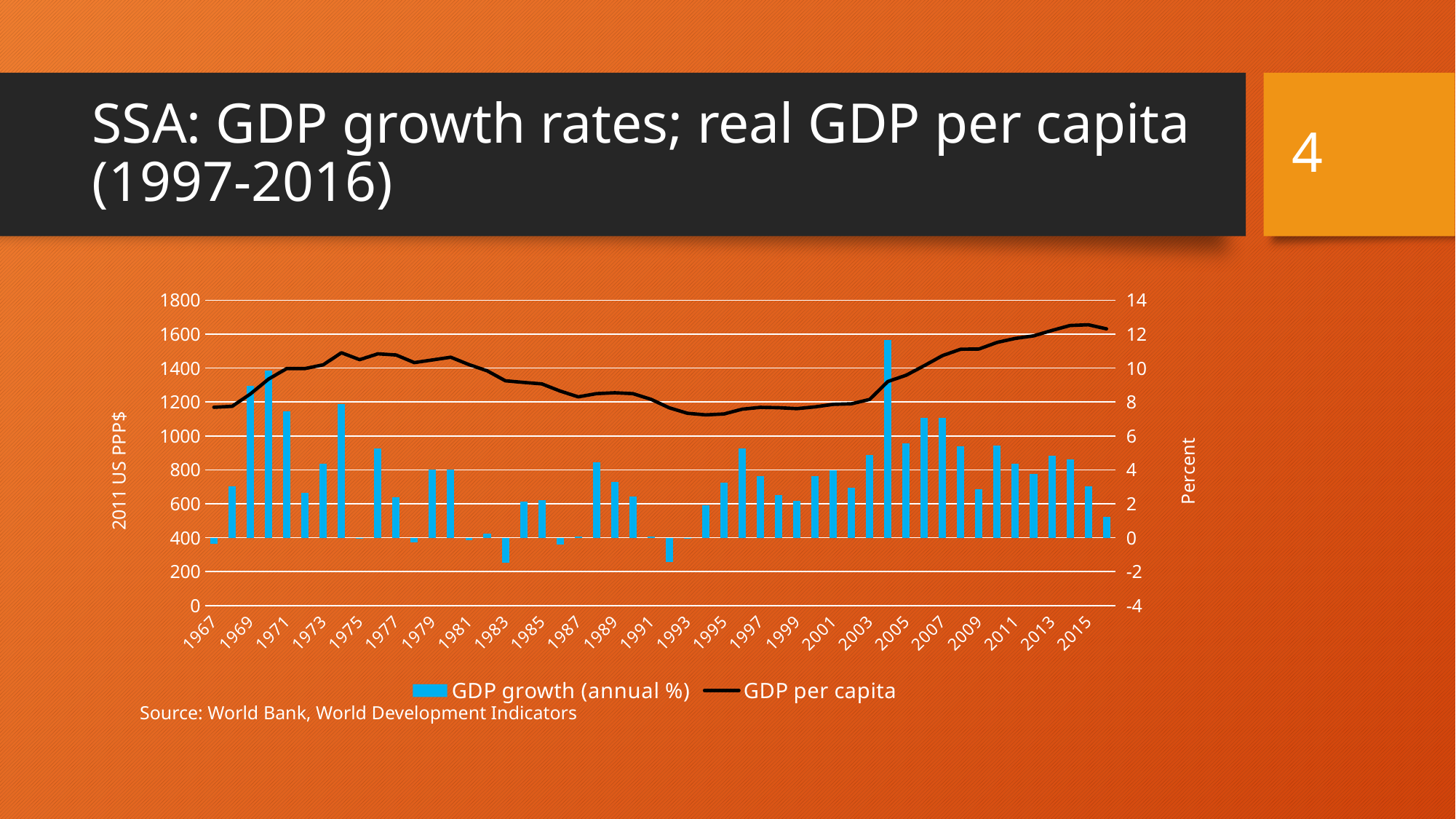
What kind of chart is shown on the slide? A combined bar and line chart Is the GDP growth (annual %) value for 2004 greater or less than 10? greater Is the GDP growth (annual %) value for 1983 greater or less than 0? less How many series does the legend list? 2 What is the title of the left vertical axis? 2011 US PPP$ Is the GDP per capita value for 2015 greater or less than 1600? greater Which year has the larger GDP per capita value, 1975 or 2015? 2015 In which year is the GDP growth (annual %) bar the highest? 2004 Does GDP per capita rise or fall between 2003 and 2015? rise Which series is drawn as bars? GDP growth (annual %) Which year has the larger GDP growth (annual %) value, 1970 or 1971? 1970